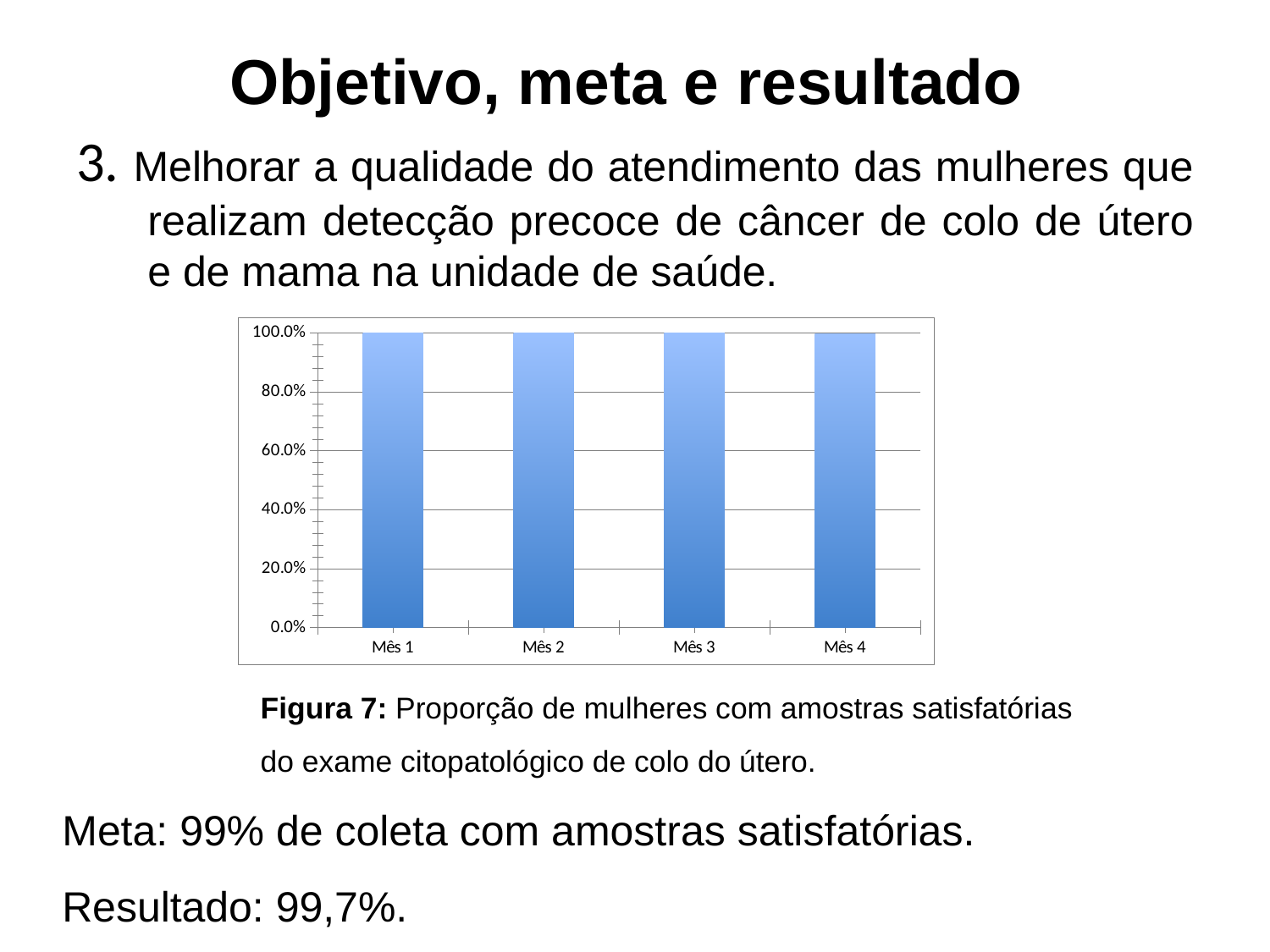
What is the value for Mês 1 in the chart? 100.0% Is the value for Mês 2 greater or less than 80.0%? greater What kind of chart is shown on the slide? bar chart What is the label of the first category on the x axis of the chart? Mês 1 What is the highest value shown on the y axis of the chart? 100.0% How many categories (months) are plotted on the x axis of the chart? 4 Is the value for Mês 4 greater or less than 60.0%? greater What is the value for Mês 3 in the chart? 100.0%